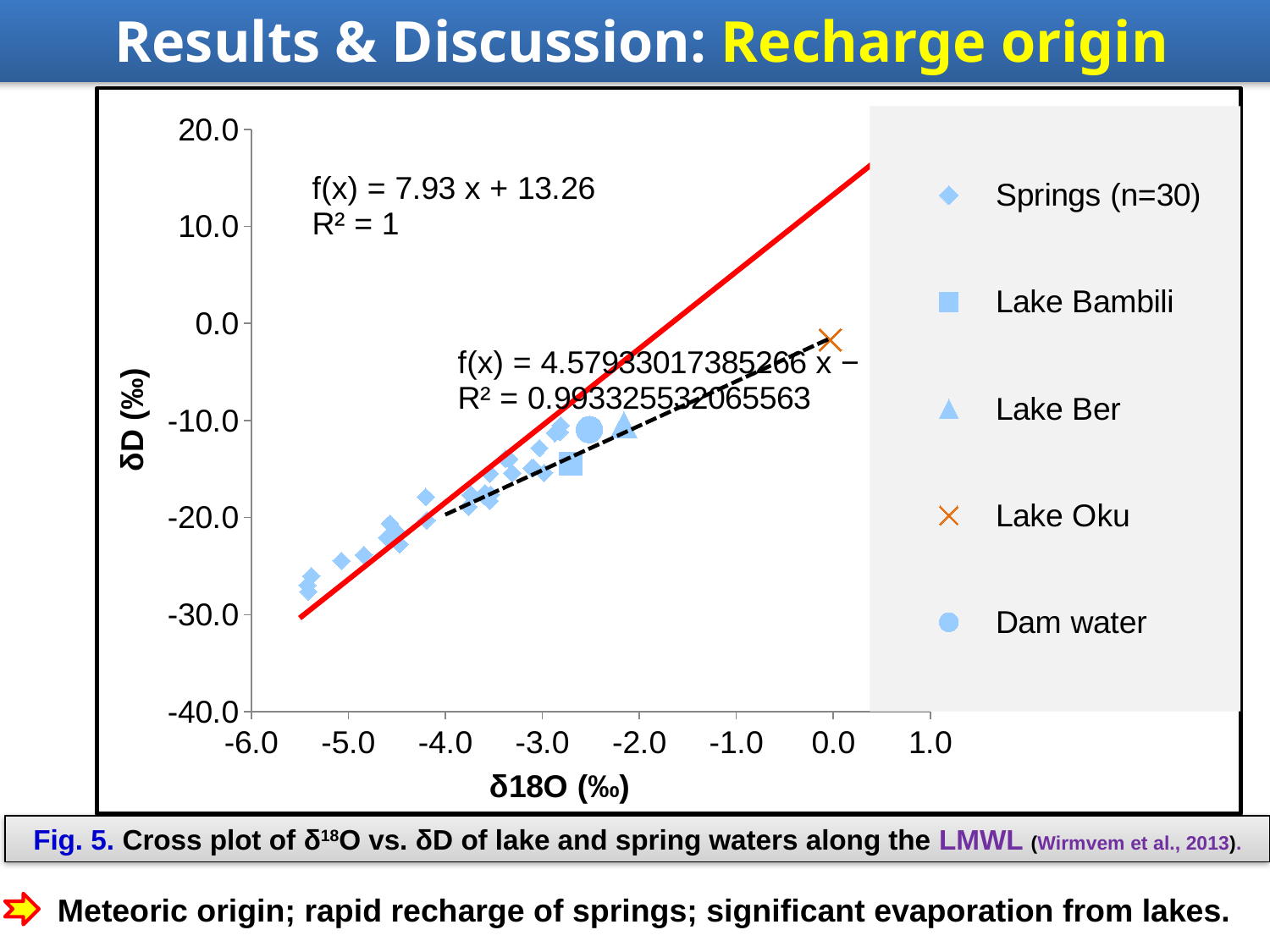
Do the δD values rise or fall as δ18O increases along the x axis? Rise What is the equation of the red trend line shown on the chart? f(x) = 7.93 x + 13.26 Is the δ18O value for Lake Oku greater or less than -1.0? greater Which series contains the lowest δD values on the chart? Springs (n=30) What is the label of the x axis? δ18O (‰) Which has a higher δD value, Lake Oku or Dam water? Lake Oku According to the legend, how many spring samples (n) are plotted? 30 Is the δD value for Lake Oku greater or less than -10.0? greater What R² value is printed for the red trend line? R² = 1 Which series has the highest δD value on the chart? Lake Oku How many series does the legend list? 5 What kind of chart is shown on the slide? Scatter plot